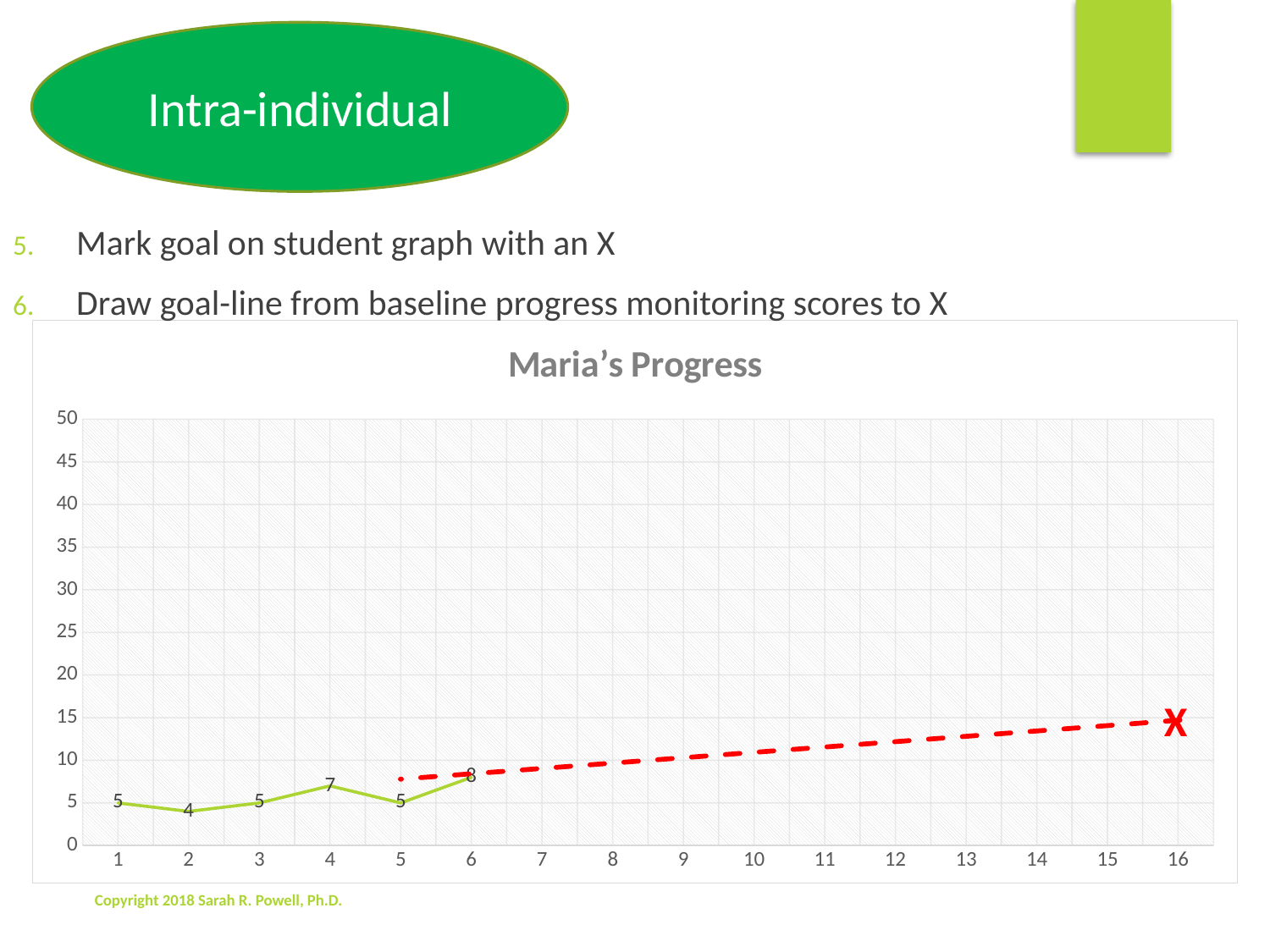
What is the value plotted at point 1? 5 Which is larger, the value at point 4 or the value at point 5? point 4 How many data points are plotted on the green line? 6 What is the value plotted at point 4? 7 What kind of chart is shown on the slide? line chart What is the difference between the values at point 6 and point 2? 4 At which point is the plotted value lowest? 2 Is the goal marked with the X at point 16 greater or less than 20? less What is the title of the chart? Maria's Progress What is the value plotted at point 2? 4 At which point is the plotted value highest? 6 What is the value plotted at point 6? 8